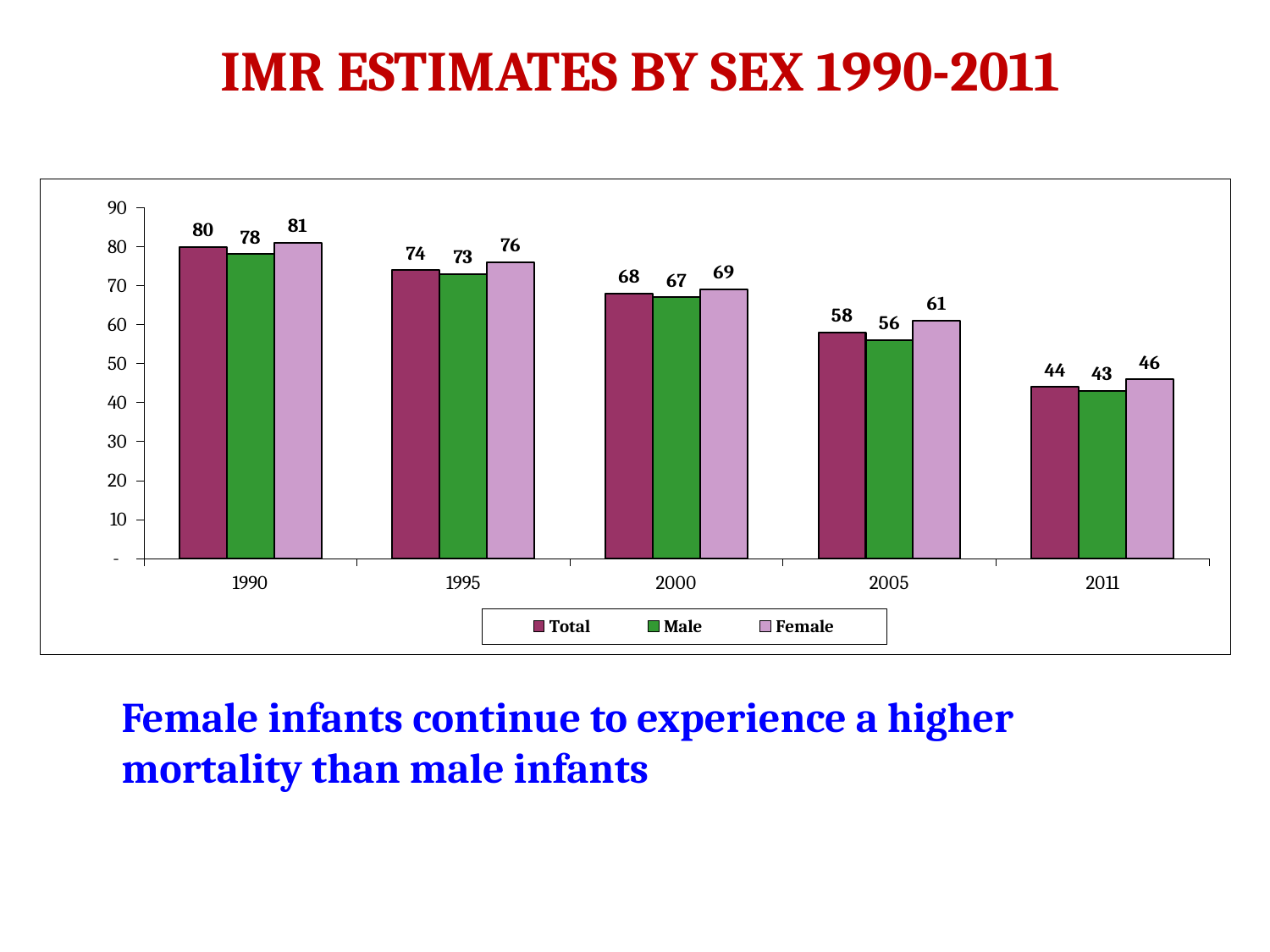
How many series does the legend list? 3 What is the Male IMR estimate for 1995? 73 How many years are shown on the x axis? 5 Which is larger in 2000, the Female or the Male IMR estimate? Female What is the Female IMR estimate for 2005? 61 What is the difference between the Female and Male IMR estimates in 2005? 5 In which year is the Total IMR estimate highest? 1990 Do the Total IMR estimates rise or fall from 1990 to 2011? Fall What is the Total IMR estimate for 2011? 44 In which year is the Male IMR estimate lowest? 2011 What kind of chart is shown on the slide? Bar chart What colour are the Male bars in the chart? Green